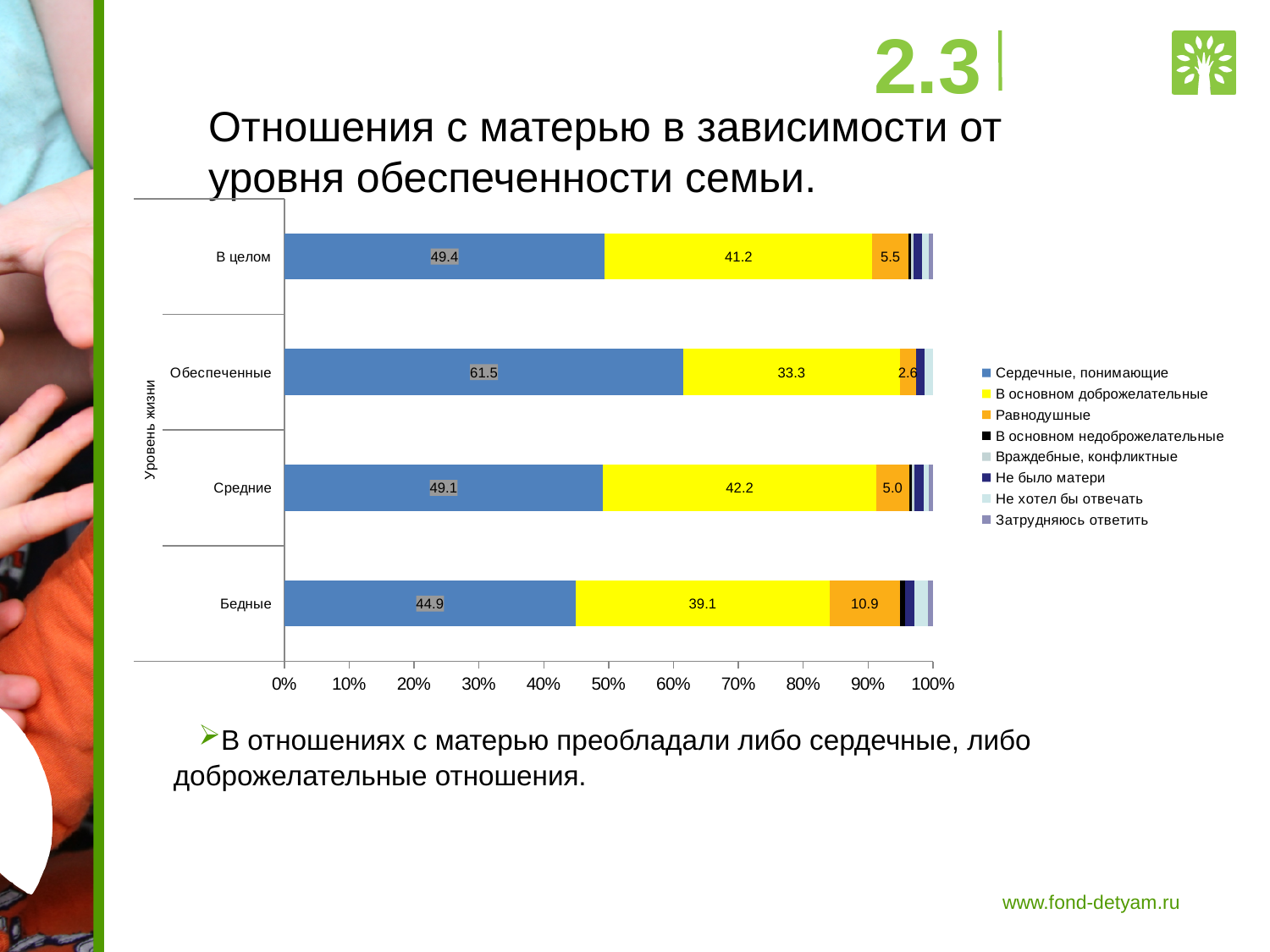
What is the label of the vertical axis of the chart? Уровень жизни What is the value of 'Сердечные, понимающие' for the 'В целом' category? 49.4 Which category has the highest value for 'Сердечные, понимающие'? Обеспеченные How many categories are shown on the vertical axis of the chart? 4 Which is larger: the 'В основном доброжелательные' value for 'В целом' or for 'Обеспеченные'? В целом How many series does the legend list? 8 What is the value of 'В основном доброжелательные' for the 'Средние' category? 42.2 What is the difference between the 'Сердечные, понимающие' values for 'Обеспеченные' and 'Бедные'? 16.6 What is the value of 'Сердечные, понимающие' for the 'Обеспеченные' category? 61.5 What kind of chart is shown on the slide? Stacked bar chart What is the value of 'Равнодушные' for the 'Бедные' category? 10.9 Which category has the lowest value for 'Равнодушные'? Обеспеченные